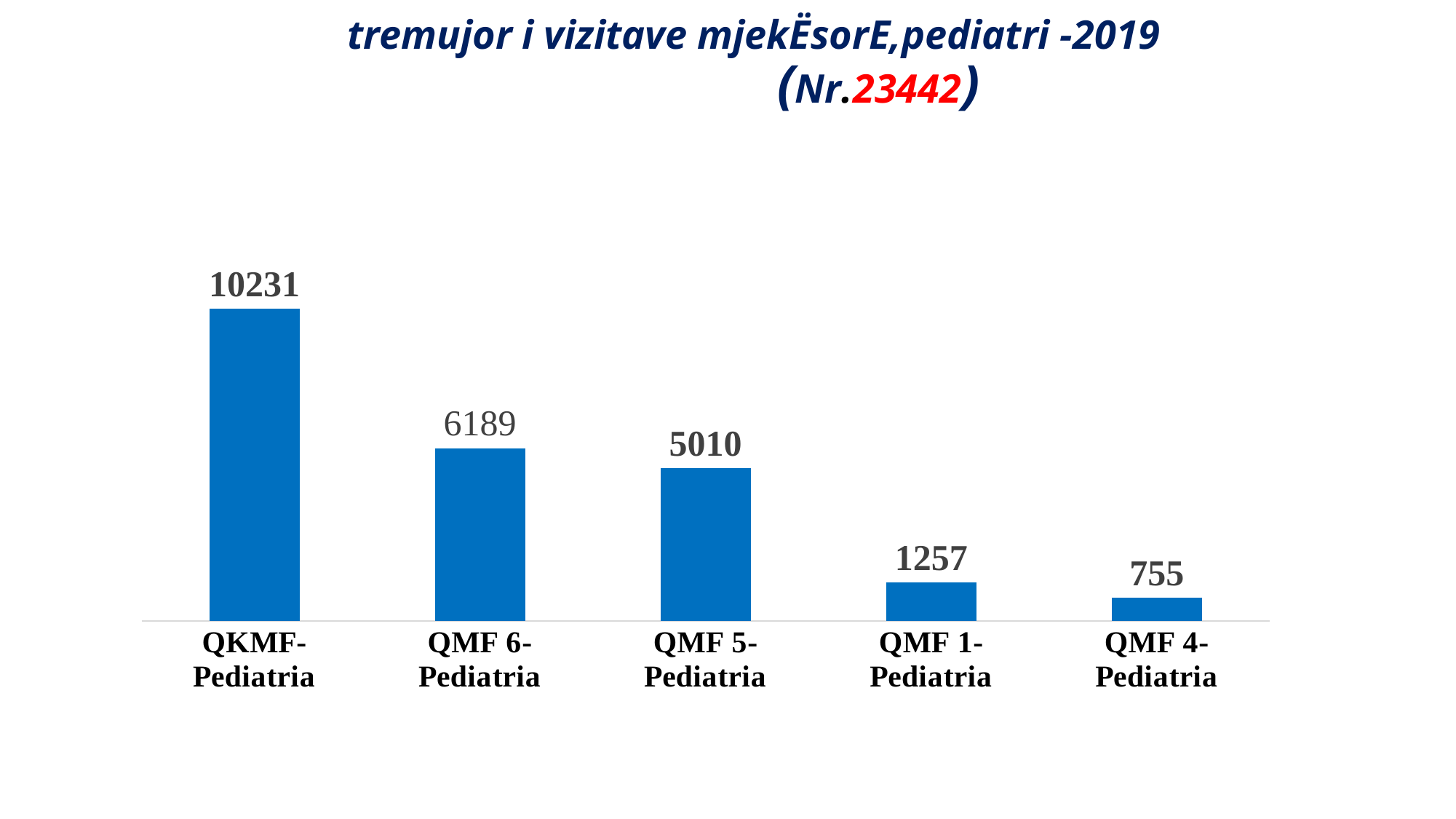
How many categories are shown in the chart? 5 Which is larger, the value for QMF 5-Pediatria or QMF 1-Pediatria? QMF 5-Pediatria What kind of chart is shown on the slide? Bar chart What is the value for QMF 5-Pediatria? 5010 Do the values rise or fall from left to right along the x axis? Fall Which category has the highest value? QKMF-Pediatria What is the value for QMF 6-Pediatria? 6189 What is the value for QMF 4-Pediatria? 755 What is the value for QKMF-Pediatria? 10231 What is the value for QMF 1-Pediatria? 1257 Which category has the lowest value? QMF 4-Pediatria What is the difference between the values for QKMF-Pediatria and QMF 6-Pediatria? 4042